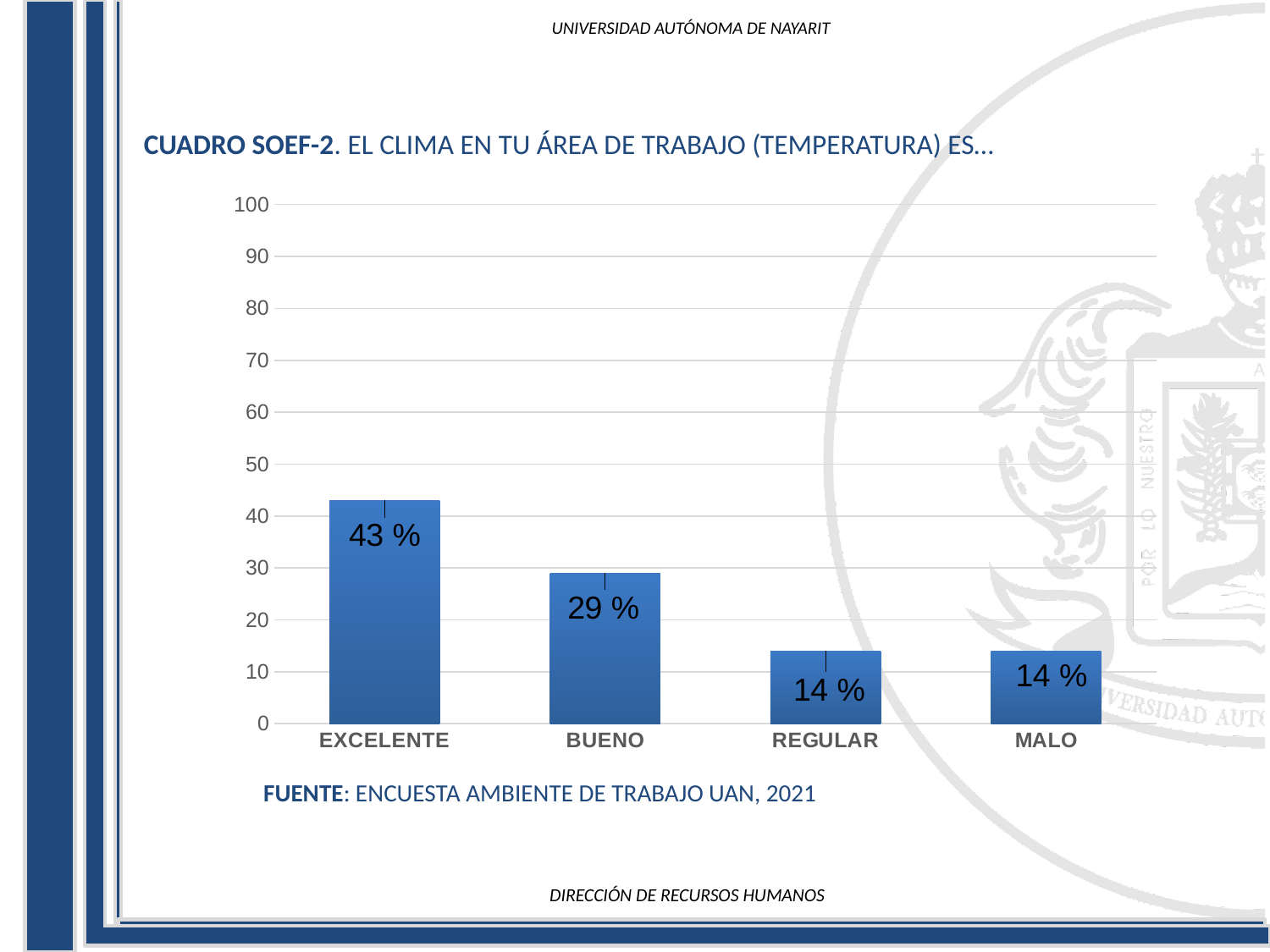
Which category has the highest value? EXCELENTE Is the value for EXCELENTE greater or less than 50? less What kind of chart is shown on the slide? bar chart Which is larger, the value for BUENO or the value for REGULAR? BUENO What is the difference between the values for BUENO and MALO? 15 % Do the values rise or fall from EXCELENTE to REGULAR along the x axis? fall What is the value for REGULAR? 14 % What is the source cited below the chart? ENCUESTA AMBIENTE DE TRABAJO UAN, 2021 What is the difference between the values for EXCELENTE and BUENO? 14 % What is the value for BUENO? 29 % What is the value for EXCELENTE? 43 % How many categories are shown on the x axis? 4